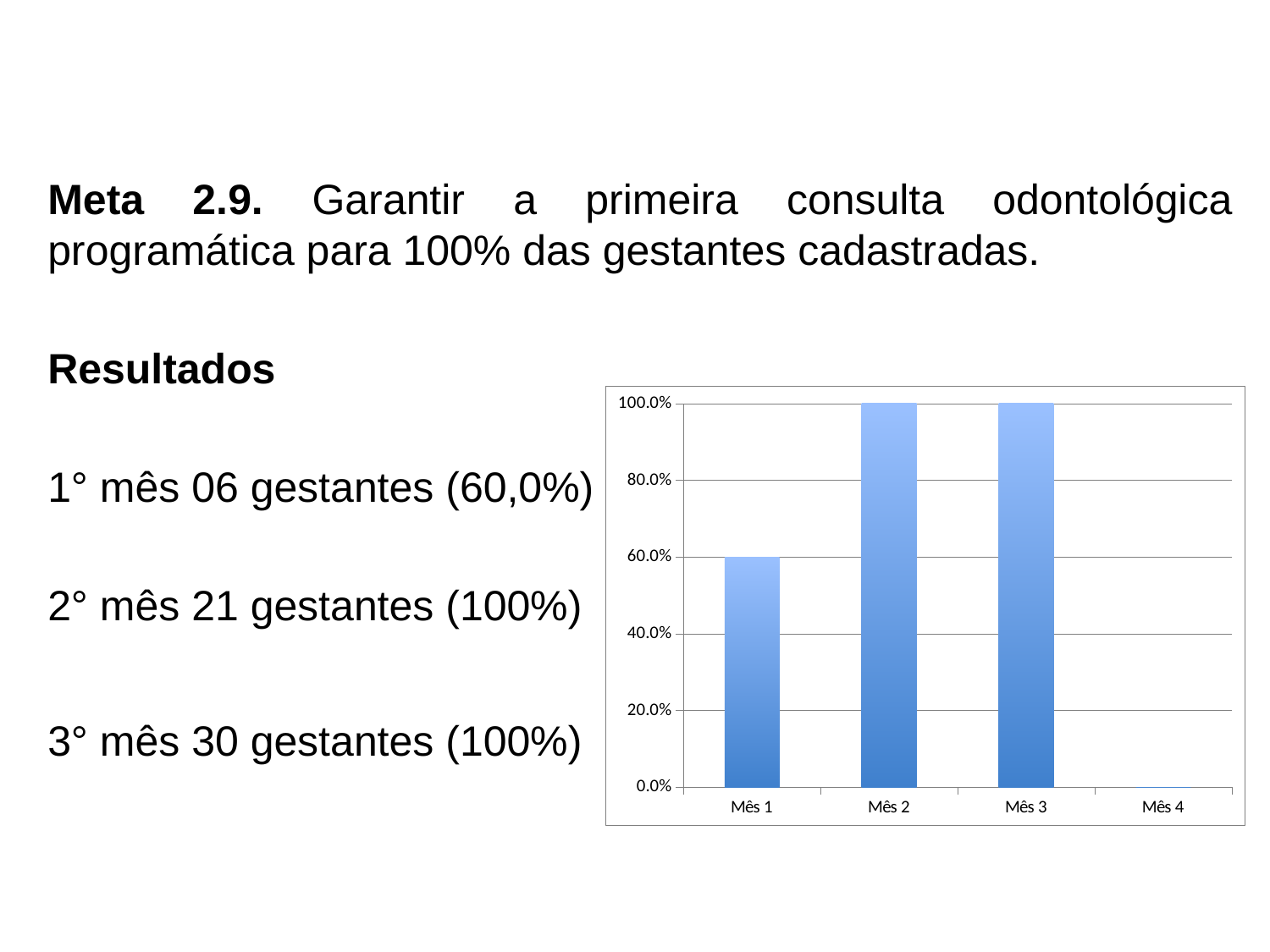
What is the label of the first category on the x axis of the chart? Mês 1 Does the value rise or fall from Mês 1 to Mês 2? rise What is the difference between the values for Mês 2 and Mês 1? 40.0% Which is larger, the value for Mês 1 or the value for Mês 3? Mês 3 Is the value for Mês 1 greater or less than 40.0%? greater Which category has the lowest value in the chart? Mês 4 What is the value for Mês 3 in the chart? 100.0% What kind of chart is shown on the slide? bar chart What is the value for Mês 1 in the chart? 60.0% What is the value for Mês 4 in the chart? 0.0% What is the value for Mês 2 in the chart? 100.0% How many categories are shown on the x axis of the chart? 4